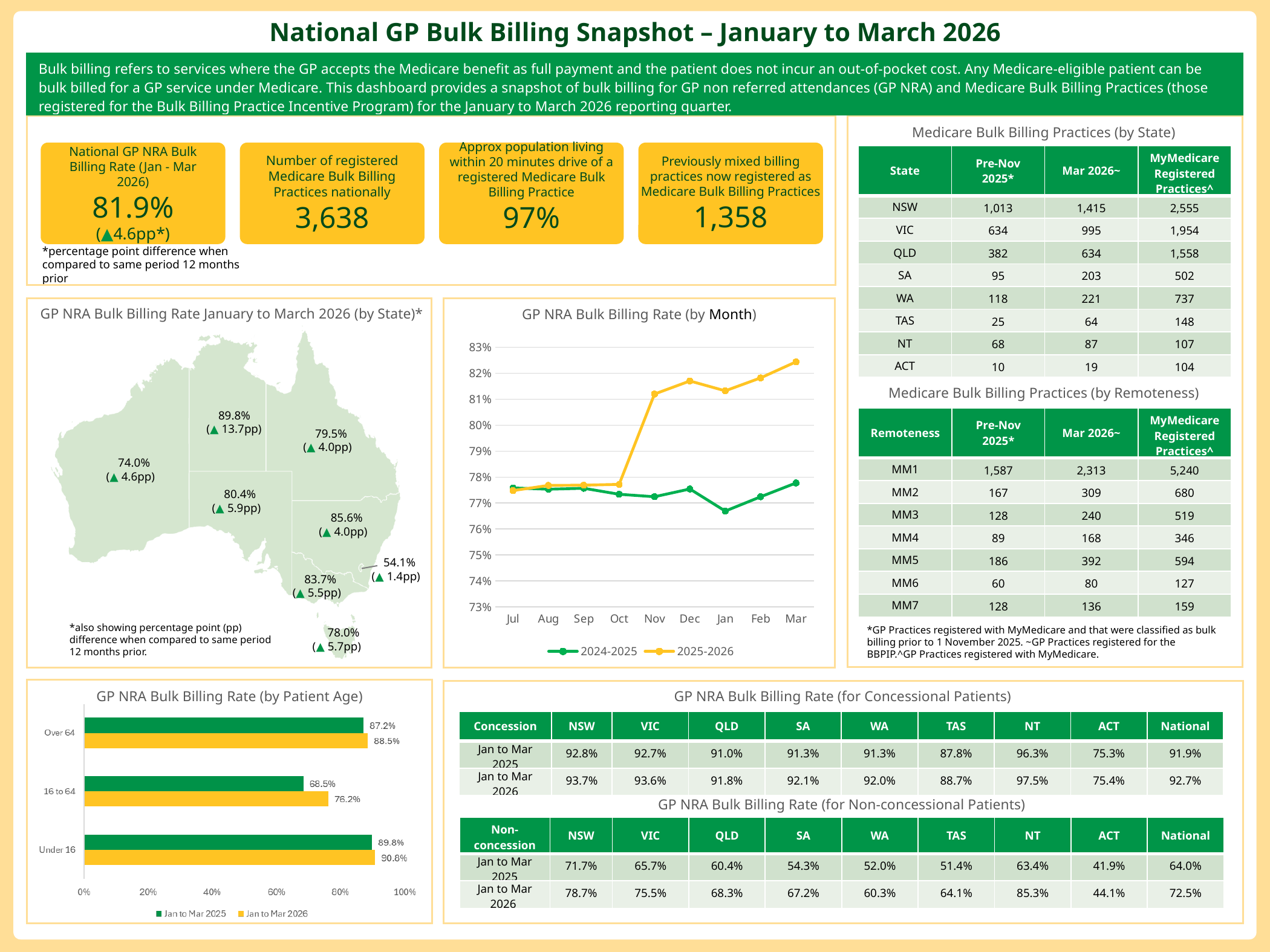
In the GP NRA Bulk Billing Rate (by Month) chart, which series has the higher value in Mar, 2024-2025 or 2025-2026? 2025-2026 In the GP NRA Bulk Billing Rate (by Patient Age) chart, how many age groups are shown? 3 In the GP NRA Bulk Billing Rate (by Patient Age) chart, which age group has the highest Jan to Mar 2026 value? Under 16 In the GP NRA Bulk Billing Rate (by Patient Age) chart, what is the Jan to Mar 2026 value for the 16 to 64 age group? 76.2% In the GP NRA Bulk Billing Rate (by Patient Age) chart, how many series does the legend list? 2 In the GP NRA Bulk Billing Rate (by Patient Age) chart, what is the difference between the Jan to Mar 2026 and Jan to Mar 2025 values for the 16 to 64 age group? 7.7 percentage points In the GP NRA Bulk Billing Rate (by Month) chart, does the 2025-2026 series generally rise or fall from Jul to Mar? Rise In the GP NRA Bulk Billing Rate (by Month) chart, is the 2025-2026 value for Mar greater or less than 82%? greater In the GP NRA Bulk Billing Rate (by Patient Age) chart, what is the Jan to Mar 2025 value for Over 64? 87.2% In the GP NRA Bulk Billing Rate (by Month) chart, is the 2024-2025 value for Jan greater or less than 77%? less In the GP NRA Bulk Billing Rate (by Patient Age) chart, which age group has the lowest Jan to Mar 2025 value? 16 to 64 What kind of chart is the GP NRA Bulk Billing Rate (by Patient Age) chart? Bar chart